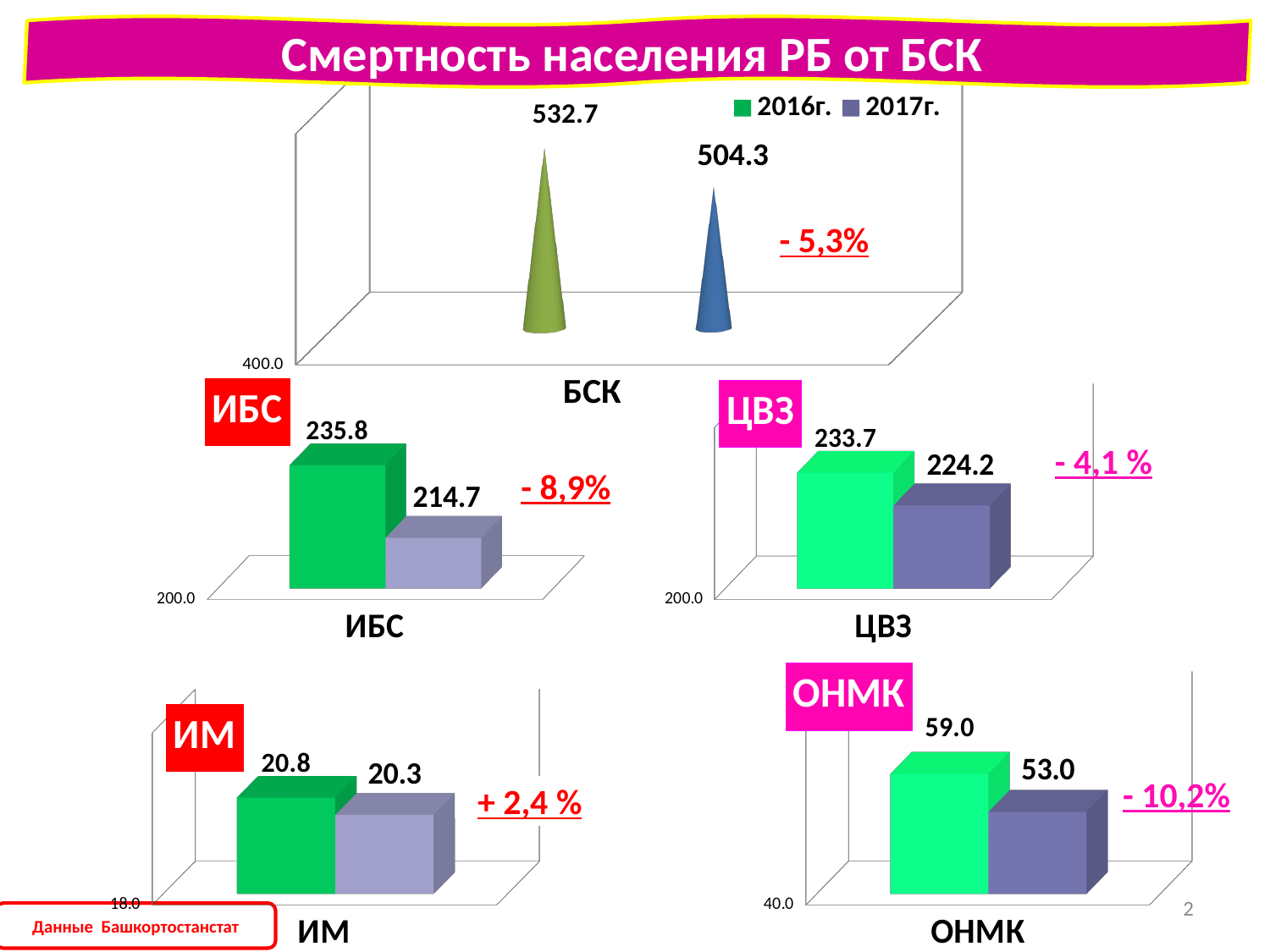
In the ИБС chart, what is the difference between the 2016г. and 2017г. values? 21.1 In the ЦВЗ chart, what is the value for 2016г.? 233.7 In the ИБС chart, what is the value for 2017г.? 214.7 In the ИМ chart, what is the value for 2017г.? 20.3 What kind of chart is the ИБС chart? bar chart How many series does the legend at the top of the slide list? 2 In the ОНМК chart, which year has the larger value, 2016г. or 2017г.? 2016г. In the БСК chart at the top, what is the value for 2017г.? 504.3 In the ЦВЗ chart, what is the difference between the 2016г. and 2017г. values? 9.5 In the ОНМК chart, what is the value for 2016г.? 59.0 In the БСК chart at the top, what is the value for 2016г.? 532.7 What percentage change is printed next to the ОНМК chart? - 10,2%